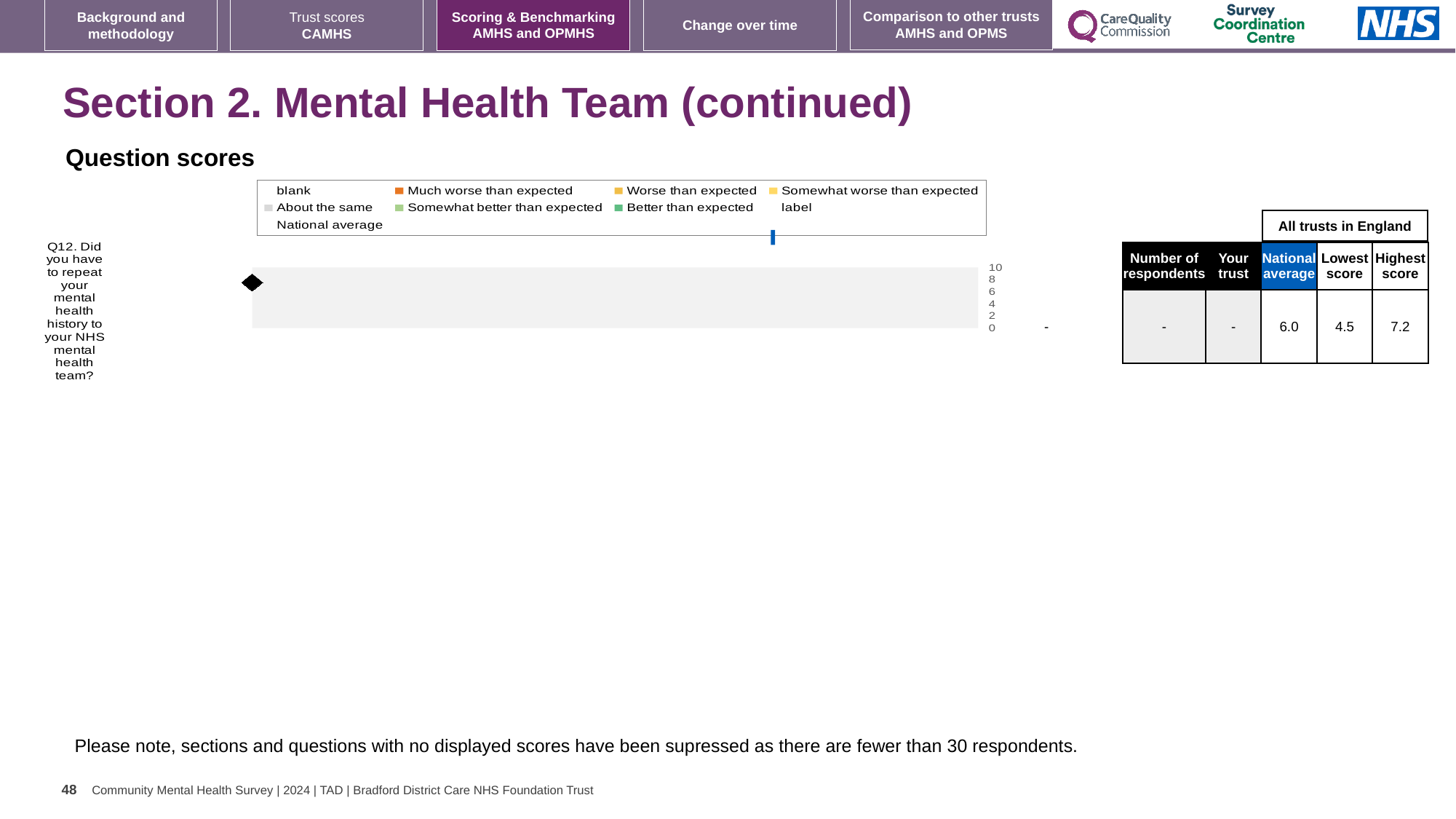
In the table beside the chart, what is the national average score for Q12? 6.0 In the table beside the chart, what value is shown for 'Your trust' for Q12? - Which question is plotted in the Question scores chart? Q12. Did you have to repeat your mental health history to your NHS mental health team? In the table beside the chart, is the national average for Q12 greater or less than 5? greater In the table beside the chart, what is the highest score among all trusts in England for Q12? 7.2 What kind of chart is shown under 'Question scores'? bar chart How many questions (categories) are plotted in the Question scores chart? 1 What is the highest value shown on the score axis of the Question scores chart? 10 In the table beside the chart, what is the difference between the highest score and the lowest score for Q12? 2.7 In the table beside the chart, what is the lowest score among all trusts in England for Q12? 4.5